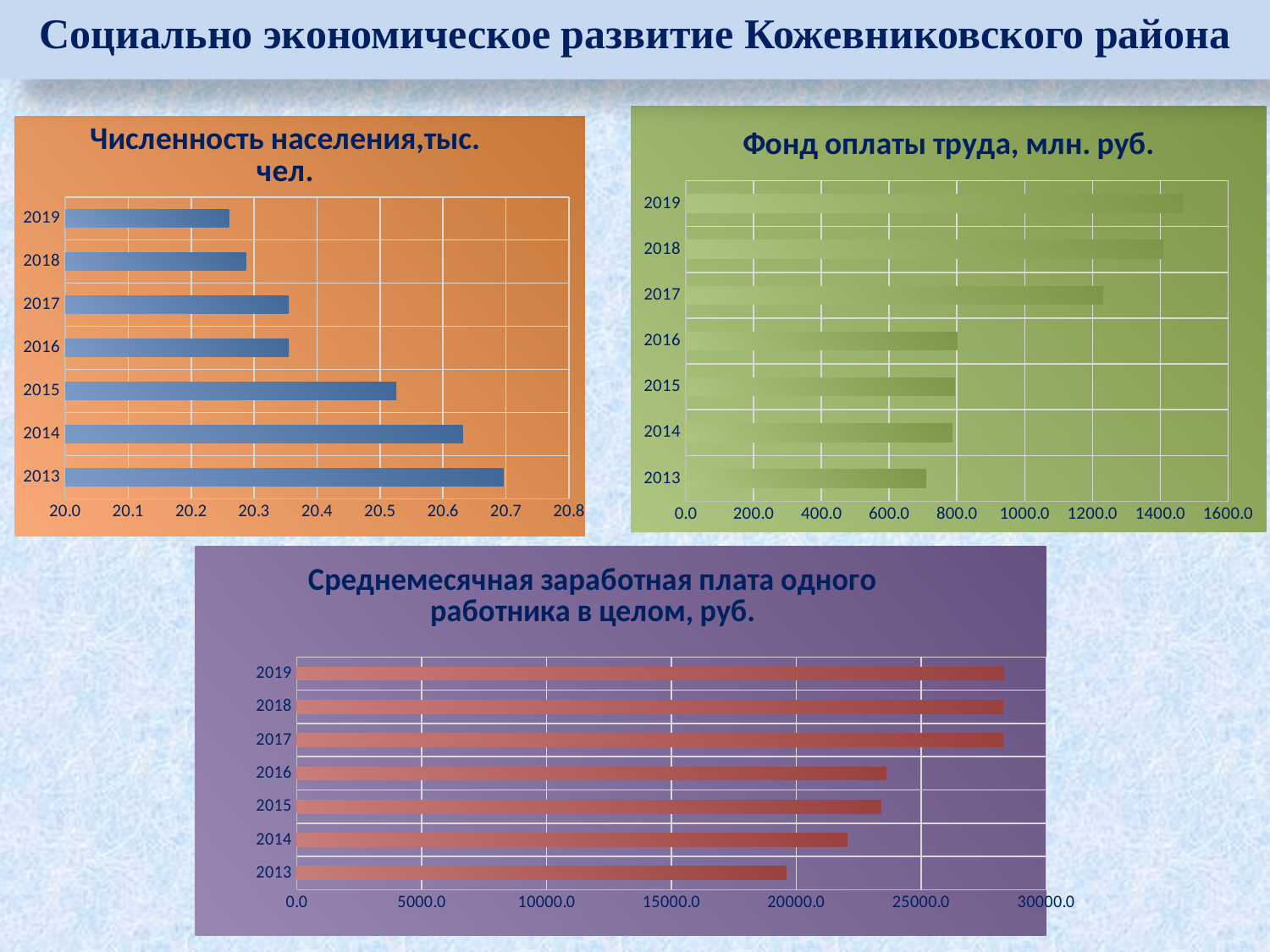
What type of chart is the one titled "Среднемесячная заработная плата одного работника в целом, руб."? bar chart In the chart titled "Численность населения,тыс. чел.", which year has the highest value? 2013 In the chart titled "Численность населения,тыс. чел.", do the values rise or fall from 2013 to 2019? fall In the chart titled "Численность населения,тыс. чел.", is the value for 2013 greater or less than 20.6? greater In the chart titled "Фонд оплаты труда, млн. руб.", is the value for 2017 greater or less than 1200.0? greater In the chart titled "Фонд оплаты труда, млн. руб.", is the value for 2013 greater or less than 800.0? less In the chart titled "Фонд оплаты труда, млн. руб.", which year has the highest value? 2019 In the chart titled "Фонд оплаты труда, млн. руб.", which year has the lowest value? 2013 In the chart titled "Среднемесячная заработная плата одного работника в целом, руб.", which year has the lowest value? 2013 In the chart titled "Фонд оплаты труда, млн. руб.", how many years are shown? 7